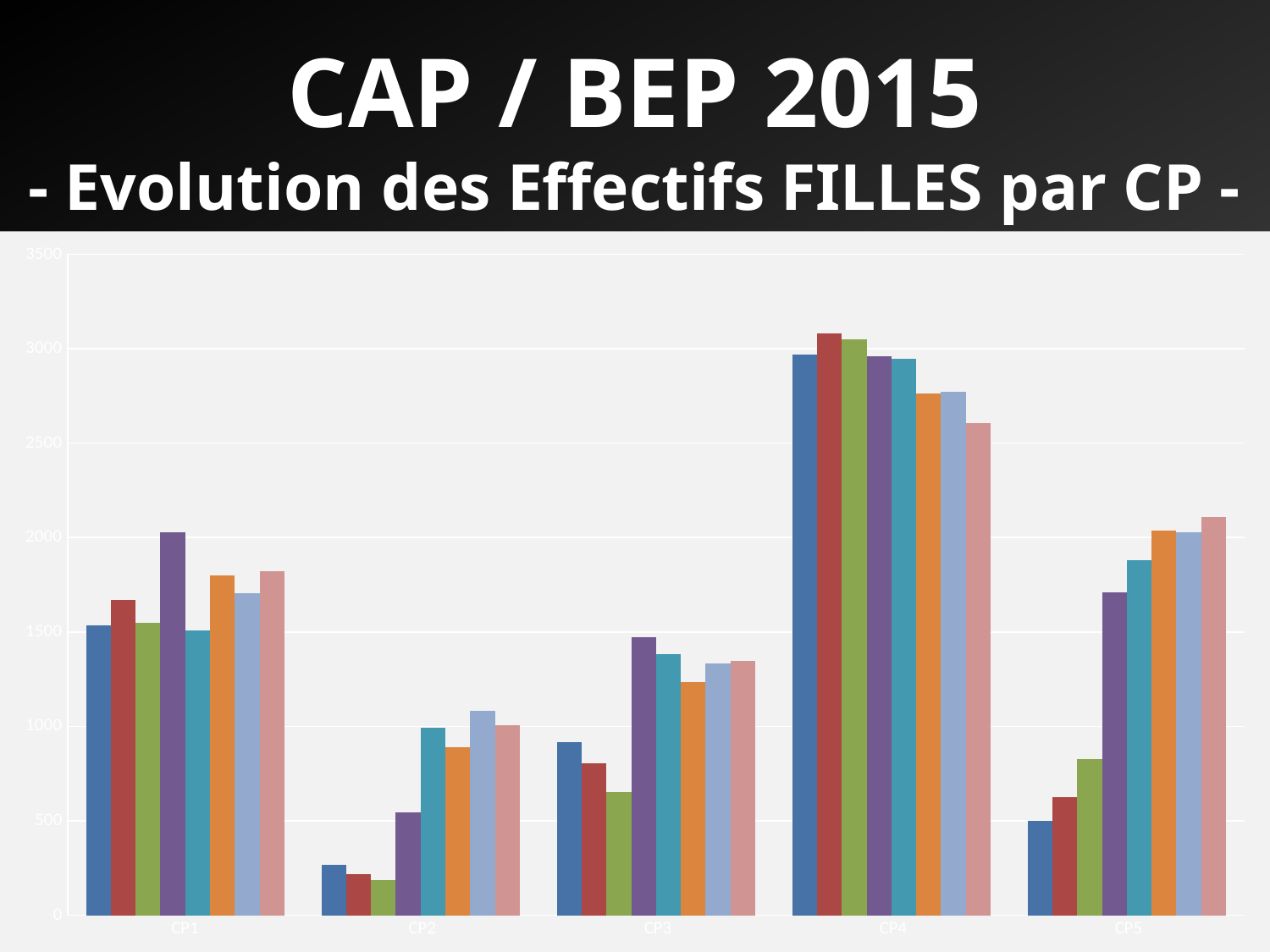
Which category has the highest bars overall? CP4 Are the bars for CP4 greater or less than 2500? greater Which category has the lowest bars overall? CP2 Is the first (blue) bar for CP2 greater or less than 500? less What is the title of the slide? CAP / BEP 2015 - Evolution des Effectifs FILLES par CP - Is the green bar for CP5 greater or less than 1000? less What kind of chart is shown on the slide? bar chart Which category has larger bars, CP4 or CP2? CP4 Within CP5, do the bars generally rise or fall from left to right? rise How many categories are shown on the x axis? 5 How many bars are plotted for each category? 8